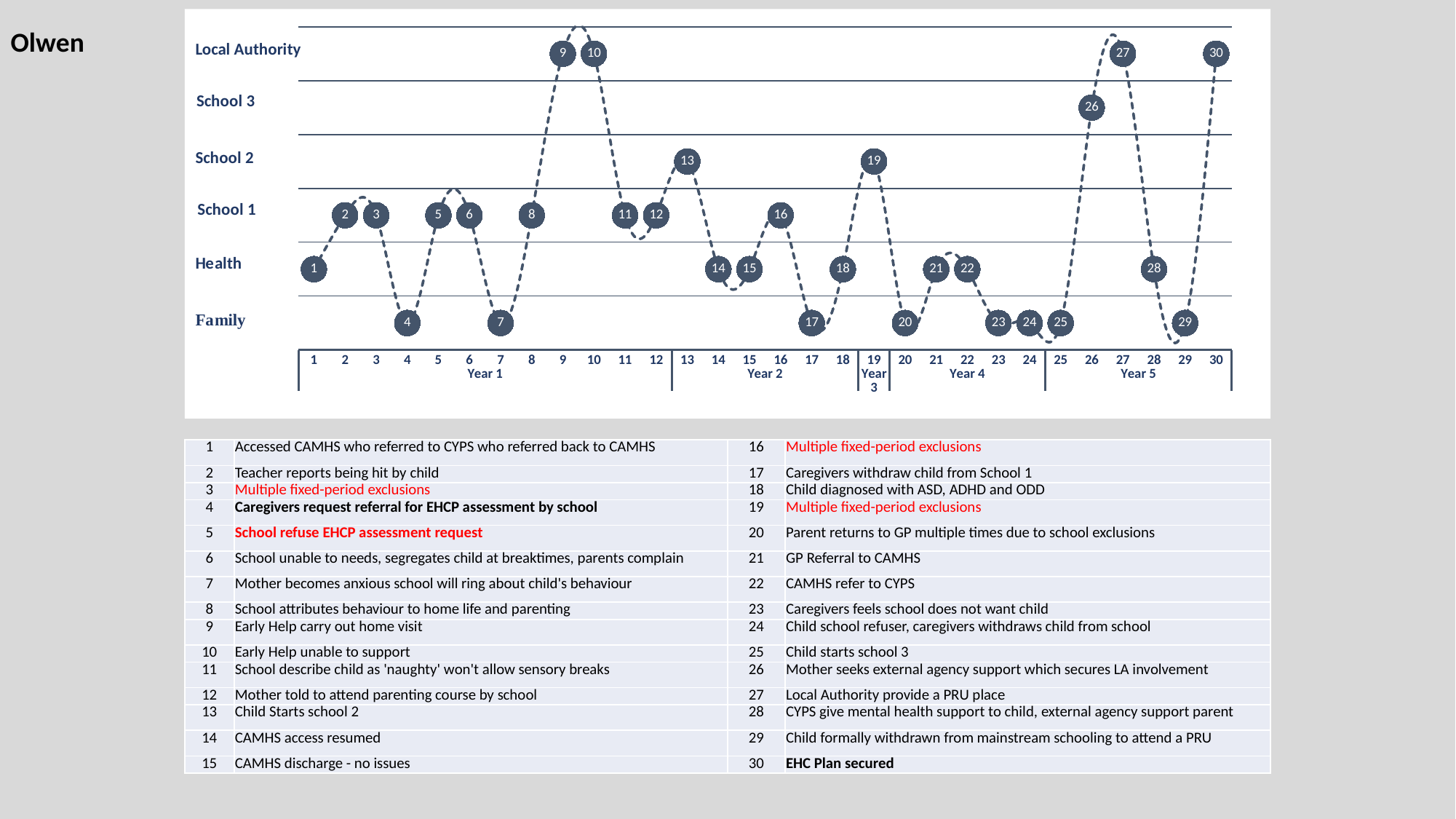
How many numbered events are plotted on the chart? 30 What is the name shown at the top left of the slide above the chart? Olwen On which row of the chart is event 13 plotted? School 2 Which events fall within Year 3 on the x axis? 19 Which year on the x axis contains the fewest events? Year 3 Which year on the x axis contains the most events? Year 1 On which row of the chart is event 1 plotted? Health How many category rows (e.g. Local Authority, Family) does the chart's vertical axis show? 6 On which row of the chart is event 26 plotted? School 3 How many events are plotted on the School 3 row? 1 What does the table say event 30 is? EHC Plan secured